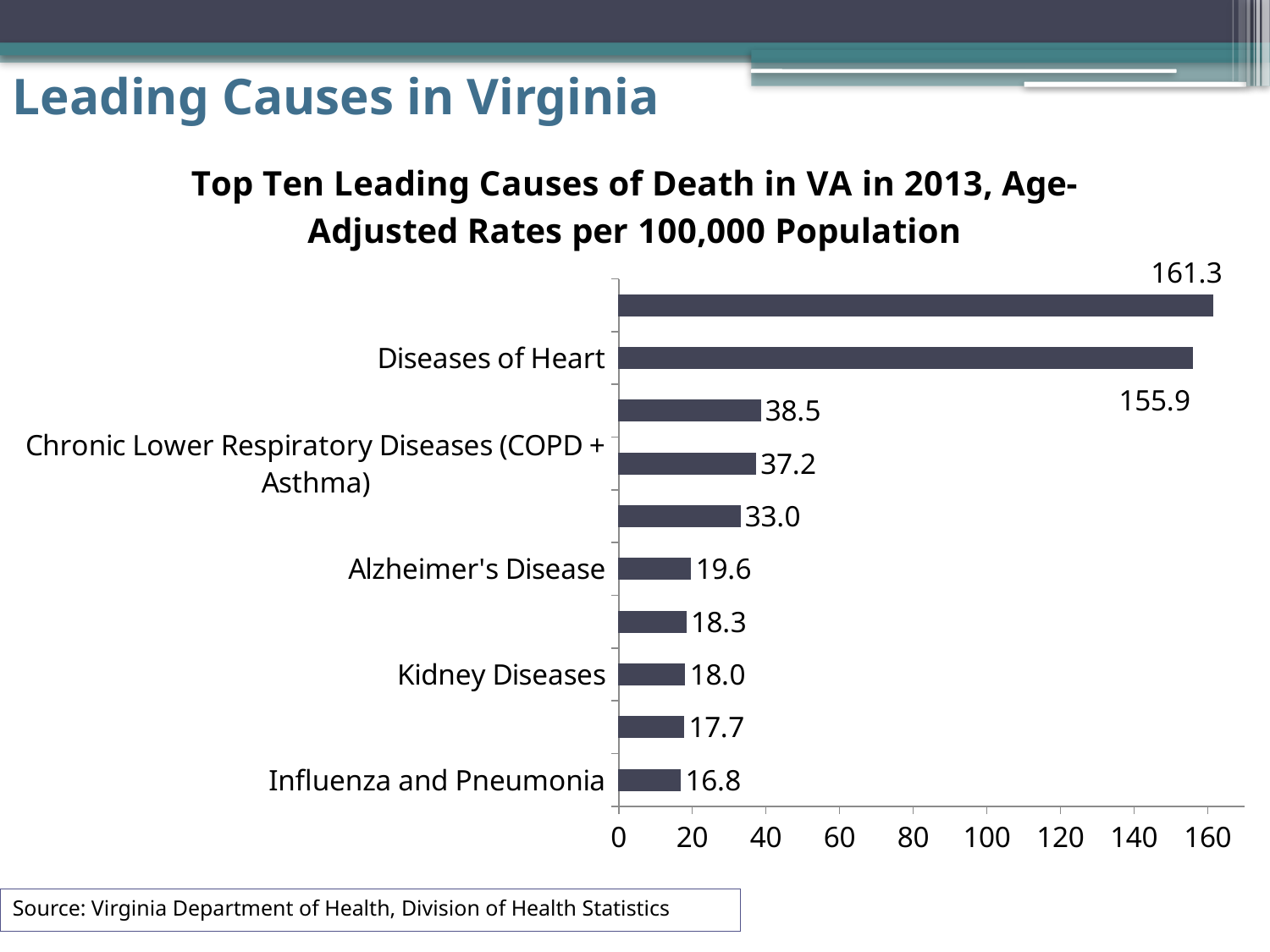
What is the value shown for Chronic Lower Respiratory Diseases (COPD + Asthma)? 37.2 What is the value shown for Alzheimer's Disease? 19.6 What is the difference between the rates for Diseases of Heart and Influenza and Pneumonia? 139.1 What is the age-adjusted death rate for Diseases of Heart? 155.9 What is the highest value shown on the chart? 161.3 Which labeled cause of death has the lowest rate on the chart? Influenza and Pneumonia Is the value for Diseases of Heart greater or less than 140? greater What is the value shown for Influenza and Pneumonia? 16.8 Which has a higher rate, Alzheimer's Disease or Kidney Diseases? Alzheimer's Disease What is the value shown for Kidney Diseases? 18.0 How many bars are plotted on the chart? 10 What type of chart is shown on the slide? Bar chart